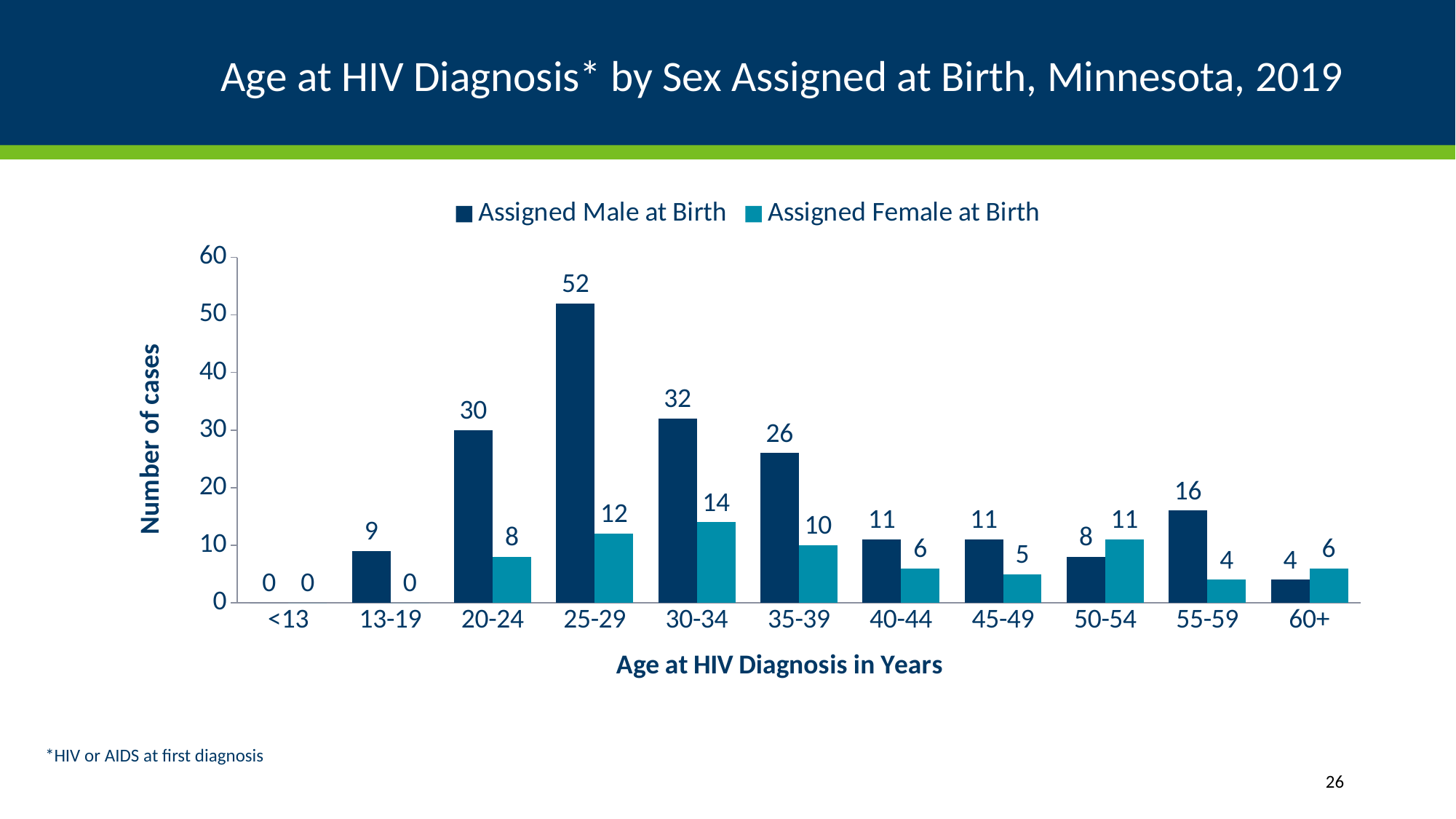
How many cases were diagnosed among those Assigned Male at Birth in the 25-29 age group? 52 In the 50-54 age group, which series has more cases, Assigned Male at Birth or Assigned Female at Birth? Assigned Female at Birth What kind of chart is shown on the slide? Bar chart How many age groups are shown on the x axis? 11 What is the label of the y axis? Number of cases How many cases were diagnosed among those Assigned Female at Birth in the 30-34 age group? 14 How many series does the legend list? 2 What is the difference between Assigned Male at Birth and Assigned Female at Birth cases in the 20-24 age group? 22 What is the total number of cases in the 35-39 age group across both series? 36 Which age group has the highest number of cases for Assigned Female at Birth? 30-34 How many cases were diagnosed among those Assigned Male at Birth in the 60+ age group? 4 Which age group has the highest number of cases for Assigned Male at Birth? 25-29